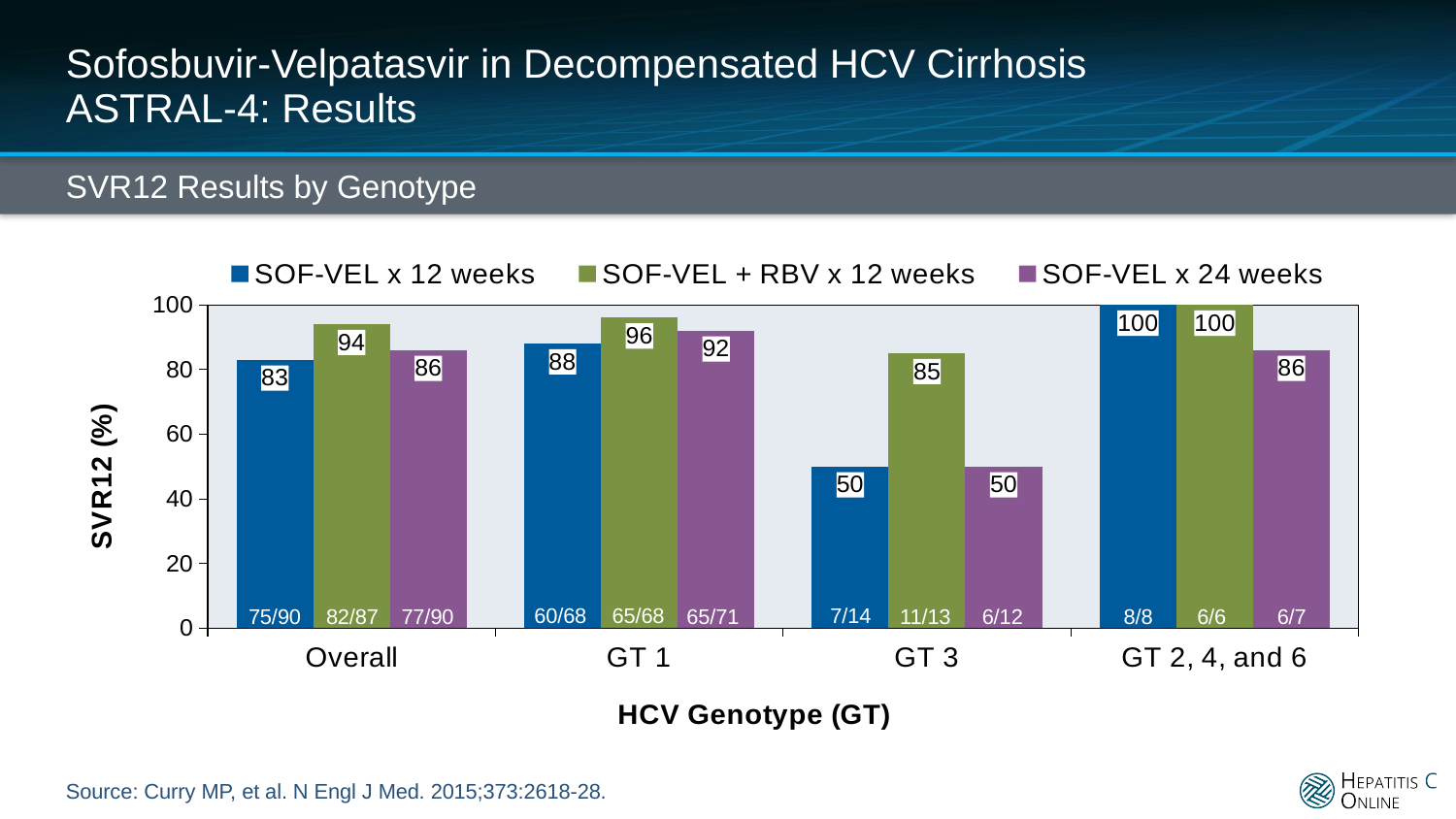
What is the difference in SVR12 (%) between SOF-VEL + RBV x 12 weeks and SOF-VEL x 12 weeks in GT 3? 35 What kind of chart is shown on the slide? Bar chart Which genotype group has the lowest SVR12 (%) for SOF-VEL x 12 weeks? GT 3 How many series does the legend list? 3 What is the SVR12 (%) for SOF-VEL x 12 weeks in the Overall group? 83 What is the label of the y axis? SVR12 (%) How many genotype groups are shown on the x axis? 4 Which is larger in GT 1: the SVR12 (%) for SOF-VEL x 12 weeks or for SOF-VEL x 24 weeks? SOF-VEL x 24 weeks What is the SVR12 (%) for SOF-VEL x 24 weeks in GT 1? 92 What is the SVR12 (%) for SOF-VEL + RBV x 12 weeks in GT 3? 85 What is the fraction shown at the base of the SOF-VEL x 24 weeks bar for GT 2, 4, and 6? 6/7 Which treatment arm has the highest SVR12 (%) in the Overall group? SOF-VEL + RBV x 12 weeks